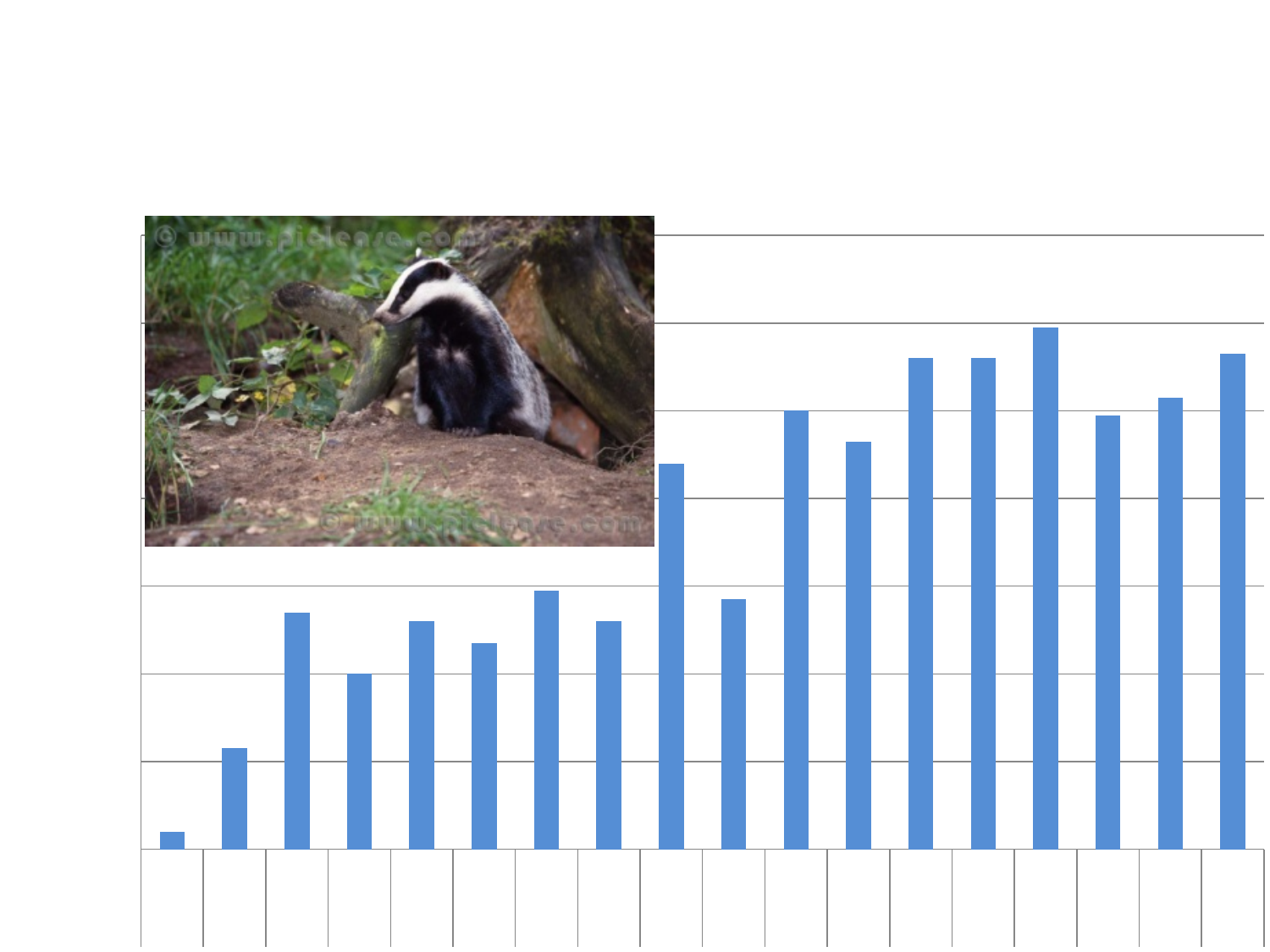
Do the bar values generally rise or fall from left to right across the chart? rise Counting from the left, which bar is the shortest in the chart? the 1st bar How many bars are plotted in the chart? 18 What kind of chart is shown on the slide? bar chart What colour are the bars in the chart? blue Counting from the left, which bar is the tallest in the chart? the 15th bar What animal is shown in the photograph overlaid on the chart? a badger Is the first bar from the left taller or shorter than the second bar? shorter